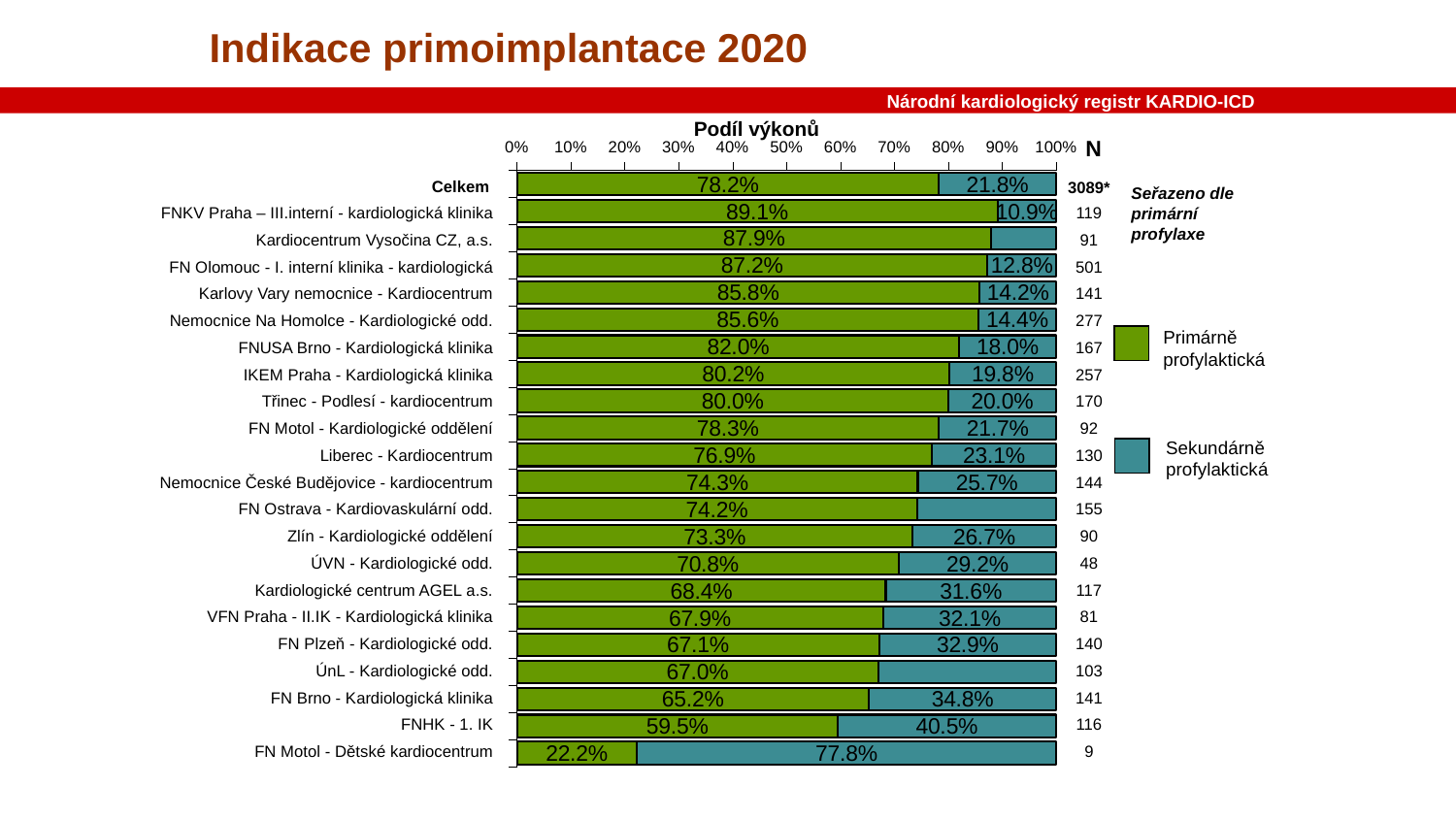
How many series does the legend list? 2 What is the N value shown for Celkem? 3089* What is the value of the Primárně profylaktická series for Celkem? 78.2% Which has a larger Primárně profylaktická share, Liberec - Kardiocentrum or Zlín - Kardiologické oddělení? Liberec - Kardiocentrum What kind of chart is shown on the slide? Stacked bar chart Is the Sekundárně profylaktická value for Kardiocentrum Vysočina CZ, a.s. greater or less than 20%? less Which category has the lowest Primárně profylaktická share? FN Motol - Dětské kardiocentrum What is the difference between the Primárně profylaktická and Sekundárně profylaktická values for FN Brno - Kardiologická klinika? 30.4 percentage points What is the value of the Sekundárně profylaktická series for FNHK - 1. IK? 40.5% Is the Sekundárně profylaktická value for FN Ostrava - Kardiovaskulární odd. greater or less than 30%? less Which category has the highest Primárně profylaktická share? FNKV Praha – III.interní - kardiologická klinika How many categories (rows) are shown in the chart? 22